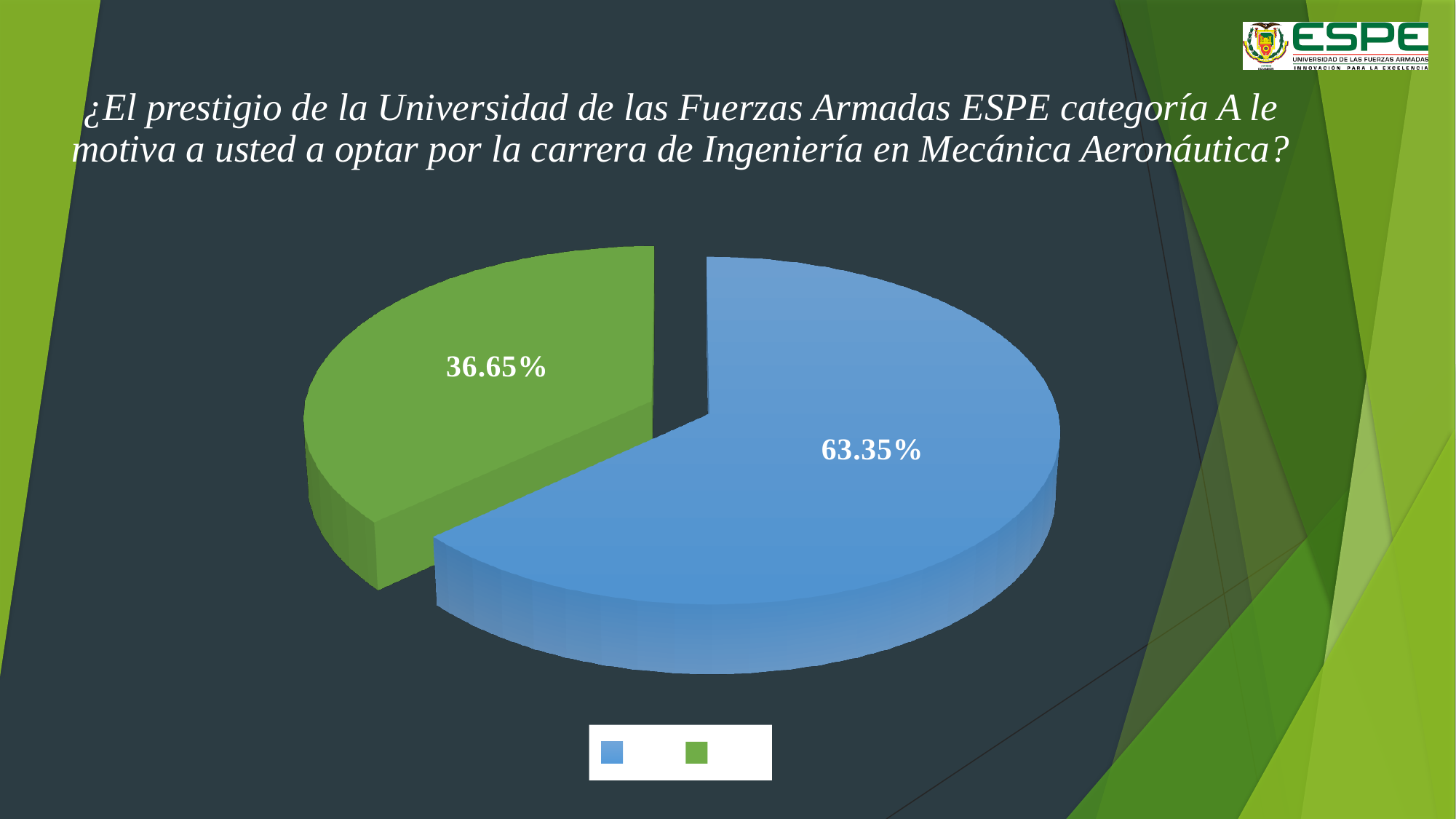
What share of the pie does the green slice represent? 36.65% What is the difference in percentage points between the blue slice and the green slice? 26.70% What percentage is shown on the green slice of the pie chart? 36.65% How many slices does the pie chart have? 2 How many entries does the legend of the pie chart list? 2 Which is larger, the blue slice or the green slice? the blue slice What kind of chart is shown on the slide? pie chart What do the two slices of the pie chart add up to? 100% What percentage is shown on the blue slice of the pie chart? 63.35% Which slice of the pie chart is the largest? the blue slice (63.35%) What colours are used for the two slices of the pie chart? blue and green Which slice of the pie chart is the smallest? the green slice (36.65%)